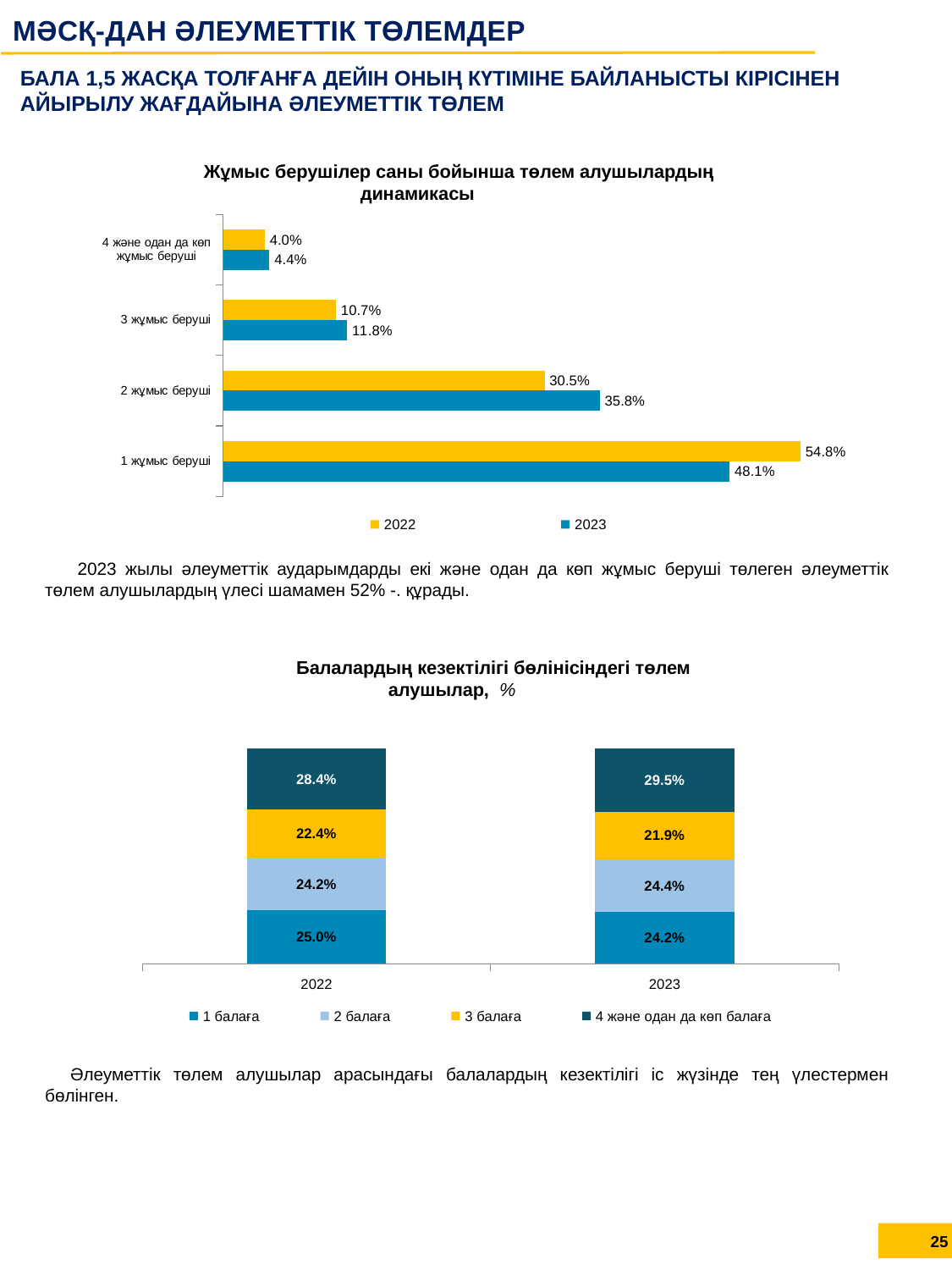
In the top chart (Жұмыс берушілер саны бойынша төлем алушылардың динамикасы), which is larger for 3 жұмыс беруші: the 2022 value or the 2023 value? 2023 In the top chart (Жұмыс берушілер саны бойынша төлем алушылардың динамикасы), how many series does the legend list? 2 In the bottom chart (Балалардың кезектілігі бөлінісіндегі төлем алушылар, %), what is the value for 3 балаға in 2023? 21.9% In the bottom chart (Балалардың кезектілігі бөлінісіндегі төлем алушылар, %), what is the value for 1 балаға in 2022? 25.0% In the bottom chart (Балалардың кезектілігі бөлінісіндегі төлем алушылар, %), which series has the largest value in 2023? 4 және одан да көп балаға In the top chart (Жұмыс берушілер саны бойынша төлем алушылардың динамикасы), what is the 2023 value for 2 жұмыс беруші? 35.8% In the bottom chart (Балалардың кезектілігі бөлінісіндегі төлем алушылар, %), how many series does the legend list? 4 In the top chart (Жұмыс берушілер саны бойынша төлем алушылардың динамикасы), what is the 2022 value for 1 жұмыс беруші? 54.8% In the top chart (Жұмыс берушілер саны бойынша төлем алушылардың динамикасы), how many categories are shown? 4 What kind of chart is the top chart (Жұмыс берушілер саны бойынша төлем алушылардың динамикасы)? Bar chart In the top chart (Жұмыс берушілер саны бойынша төлем алушылардың динамикасы), what is the difference between the 2022 and 2023 values for 1 жұмыс беруші? 6.7% In the top chart (Жұмыс берушілер саны бойынша төлем алушылардың динамикасы), which category has the lowest 2023 value? 4 және одан да көп жұмыс беруші